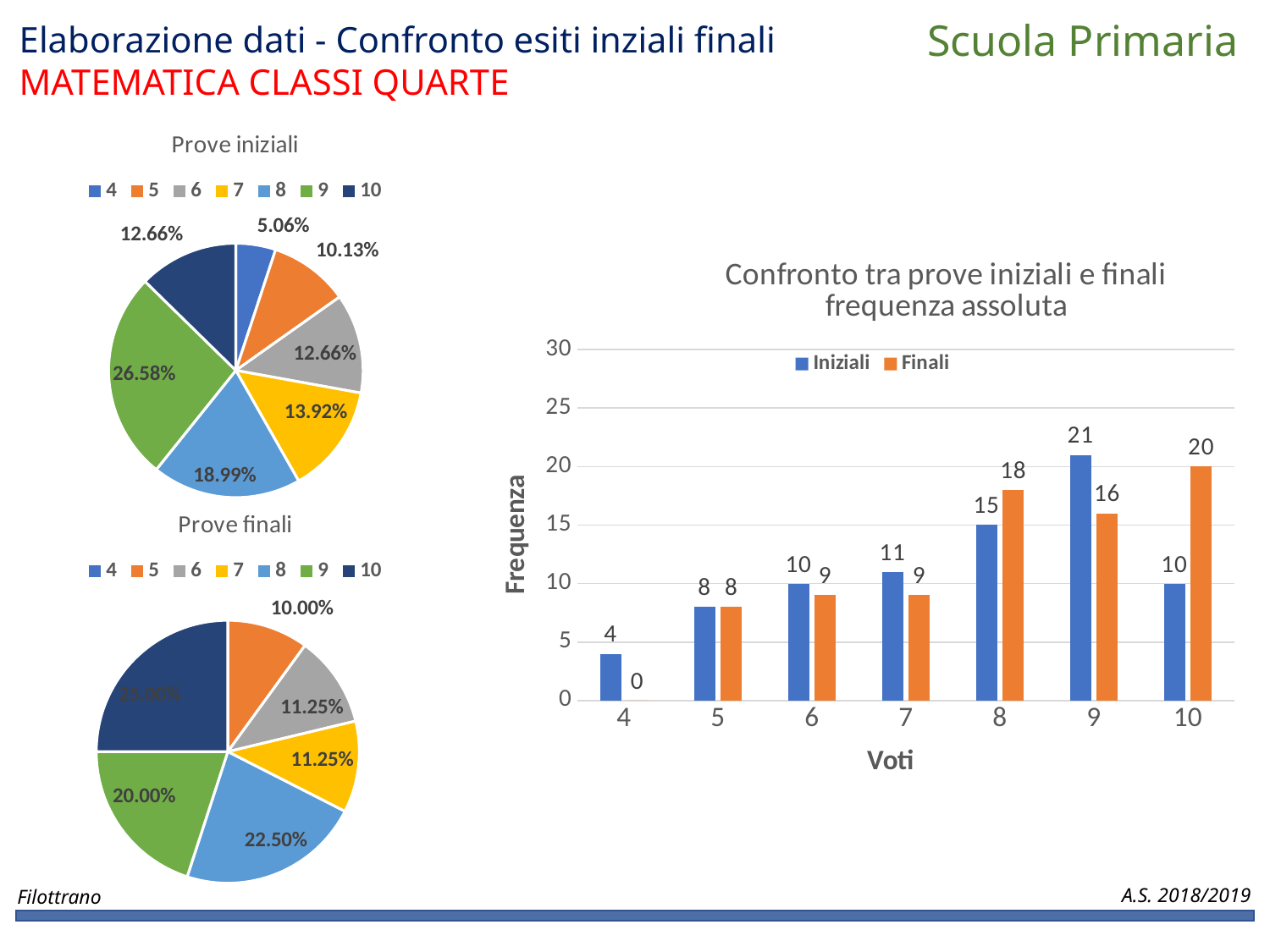
In the 'Prove iniziali' pie chart, what share does grade 9 have? 26.58% In the 'Prove finali' pie chart, what share does grade 8 have? 22.50% How many grade categories are shown on the x axis of the bar chart 'Confronto tra prove iniziali e finali frequenza assoluta'? 7 In the bar chart 'Confronto tra prove iniziali e finali frequenza assoluta', what is the difference between the Finali and Iniziali values for grade 10? 10 In the bar chart 'Confronto tra prove iniziali e finali frequenza assoluta', what is the Iniziali value for grade 9? 21 How many series does the legend of the bar chart 'Confronto tra prove iniziali e finali frequenza assoluta' list? 2 In the bar chart 'Confronto tra prove iniziali e finali frequenza assoluta', what is the Finali value for grade 10? 20 In the bar chart 'Confronto tra prove iniziali e finali frequenza assoluta', which grade has the lowest Finali value? 4 In the bar chart 'Confronto tra prove iniziali e finali frequenza assoluta', which grade has the highest Iniziali value? 9 In the 'Prove iniziali' pie chart, which grade has the smallest slice? 4 In the bar chart 'Confronto tra prove iniziali e finali frequenza assoluta', for grade 8, which is larger: Iniziali or Finali? Finali What kind of chart is 'Prove finali'? Pie chart